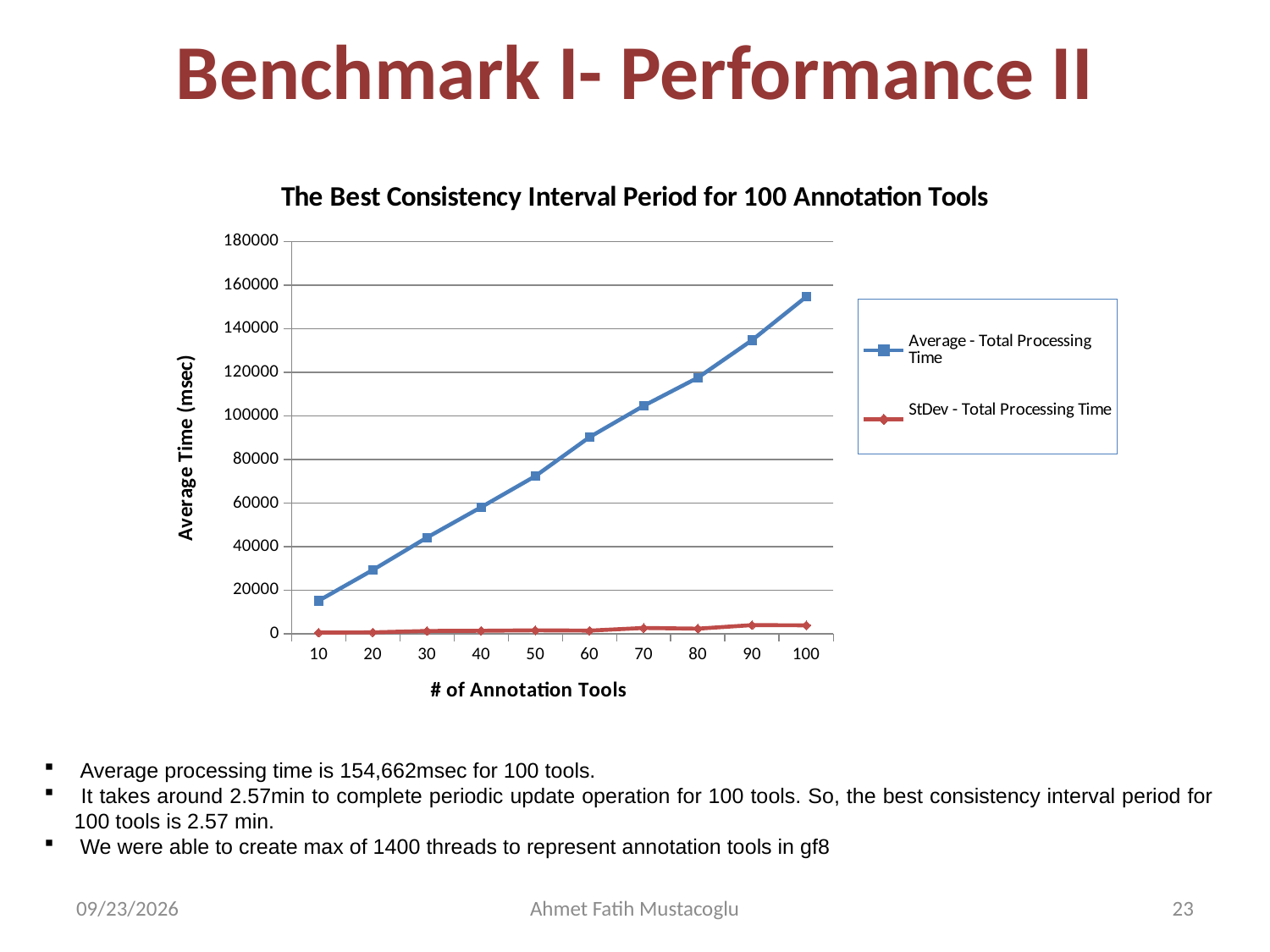
Does the Average - Total Processing Time series rise or fall as the number of annotation tools increases? rise Is the StDev - Total Processing Time for 100 annotation tools greater or less than 20000? less What kind of chart is shown on the slide? line chart Is the Average - Total Processing Time for 50 annotation tools greater or less than 60000? greater How many data points are plotted for the Average - Total Processing Time series? 10 At which number of annotation tools is the Average - Total Processing Time highest? 100 Is the Average - Total Processing Time for 100 annotation tools greater or less than 140000? greater Which series has the larger value at 100 annotation tools, Average - Total Processing Time or StDev - Total Processing Time? Average - Total Processing Time At which number of annotation tools is the Average - Total Processing Time lowest? 10 How many series does the legend list? 2 What is the title of the chart? The Best Consistency Interval Period for 100 Annotation Tools